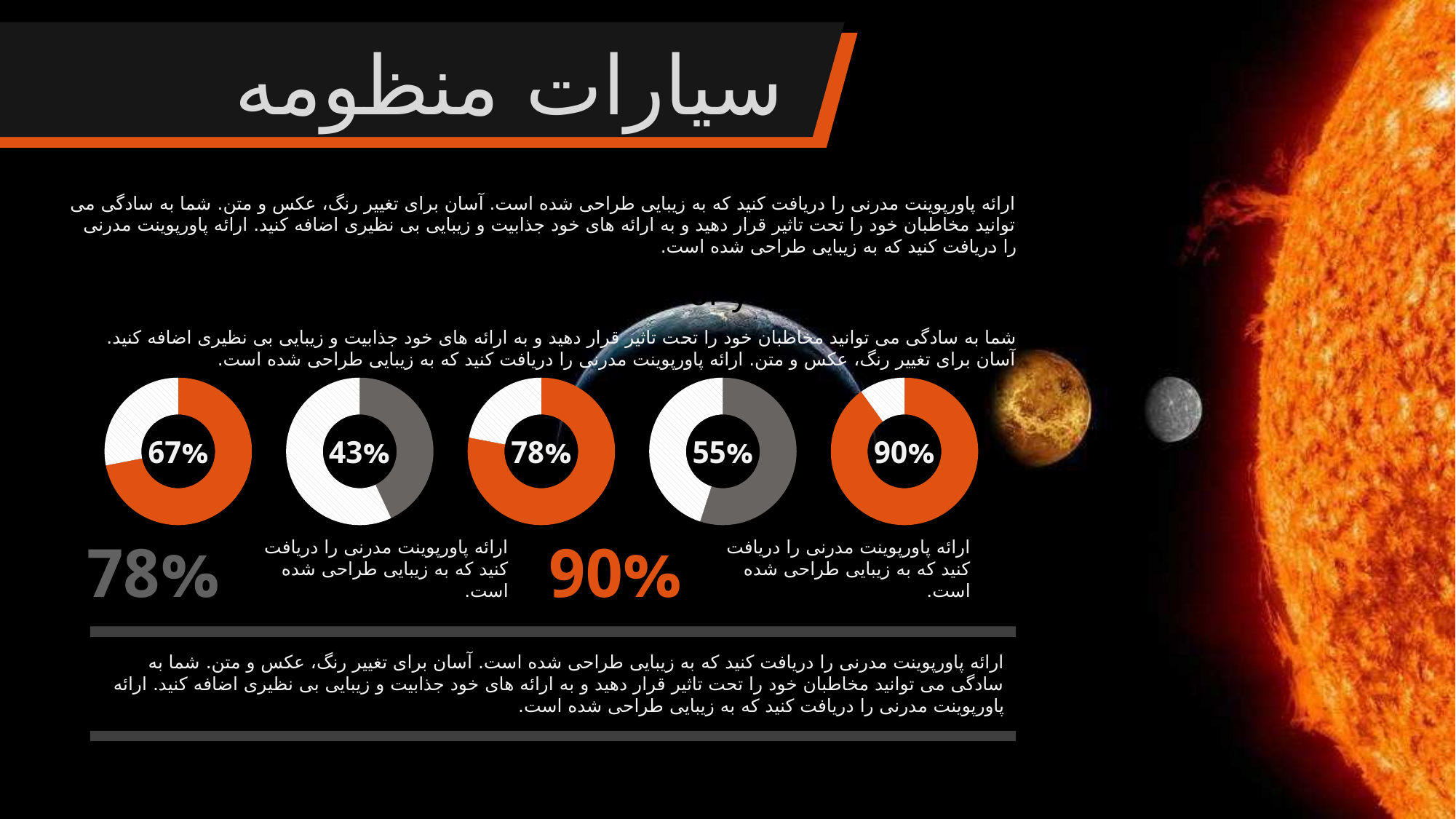
What value is shown in the centre of the second donut chart from the left? 43% What colour is the filled portion of the leftmost donut chart? Orange What kind of chart is used to display the percentages on the slide? Donut (pie) chart Which of the five donut charts shows the lowest percentage? The second from the left (43%) How many donut charts are shown on the slide? 5 What is the difference between the value in the rightmost donut chart and the value in the leftmost donut chart? 23 percentage points What value is shown in the centre of the fourth donut chart from the left? 55% What value is shown in the centre of the leftmost donut chart? 67% Which of the five donut charts shows the highest percentage? The rightmost one (90%) What value is shown in the centre of the rightmost donut chart? 90% Which is larger: the value in the third donut chart or the value in the fourth donut chart? The third donut chart (78%) What value is shown in the centre of the middle (third) donut chart? 78%